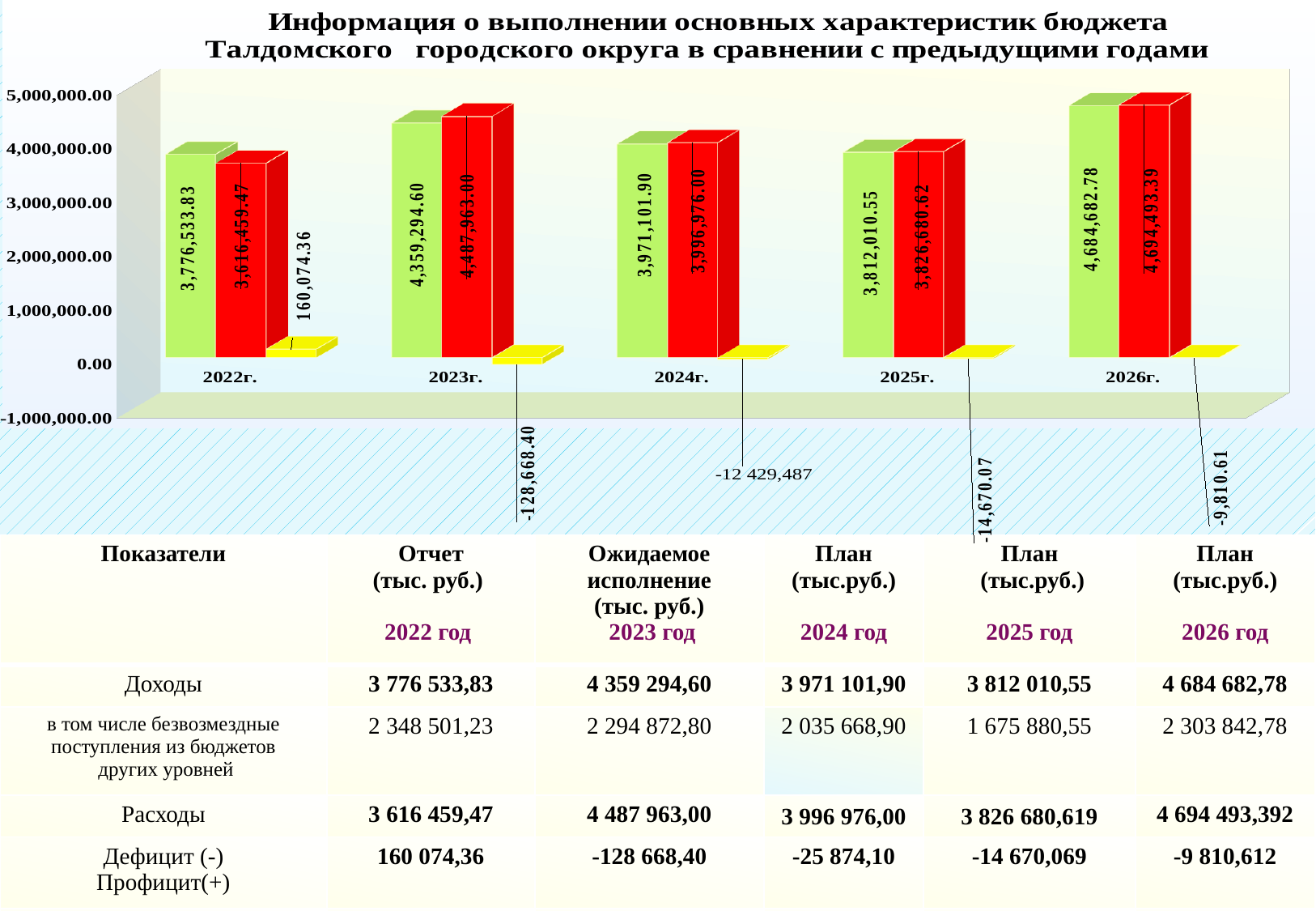
What is the title of the chart? Информация о выполнении основных характеристик бюджета Талдомского городского округа в сравнении с предыдущими годами What value is printed on the yellow bar for 2025г.? -14,670.07 Is the value of the green bar for 2023г. greater or less than 4,000,000.00? greater What value is printed on the green bar for 2022г.? 3,776,533.83 How many years are shown on the x axis of the chart? 5 What value is printed on the yellow bar for 2022г.? 160,074.36 What value is printed on the red bar for 2023г.? 4,487,963.00 In which year is the green bar the shortest? 2022г. What is the difference between the green bar and the red bar for 2022г.? 160,074.36 In which year is the green bar the tallest? 2026г. What kind of chart is shown on the slide? bar chart For 2024г., which is larger: the green bar or the red bar? the red bar